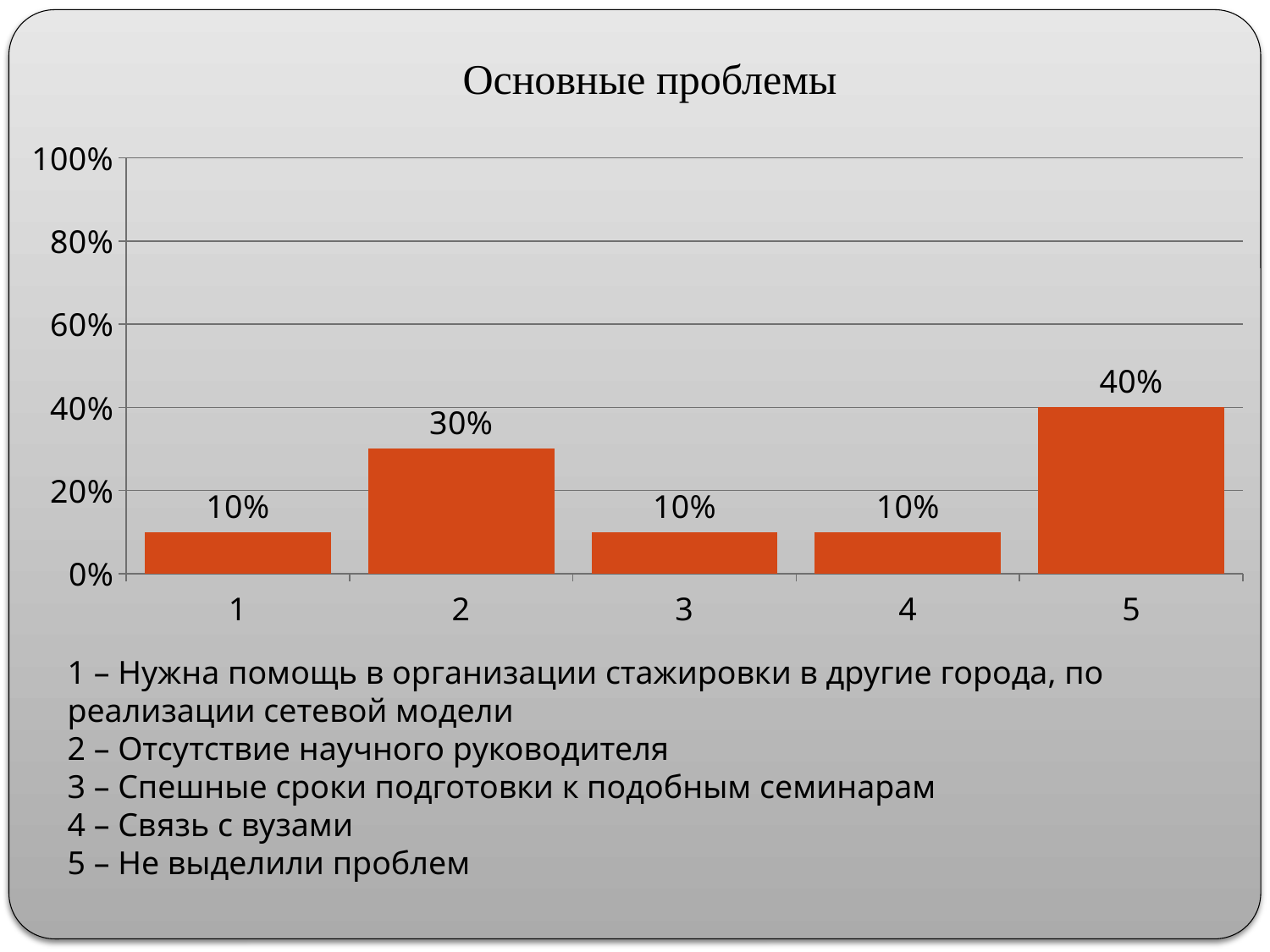
Which category has the highest value? 5 What is the value for category 2? 30% What is the value for category 5? 40% Which is larger, the value for category 2 or the value for category 4? Category 2 How many categories are shown on the x axis? 5 What is the value for category 1? 10% What is the difference between the values for category 2 and category 3? 20% What kind of chart is shown on the slide? Bar chart How many categories have a value of 10%? 3 What is the difference between the values for category 5 and category 2? 10% Is the value for category 5 greater or less than 20%? greater What is the title of the chart? Основные проблемы